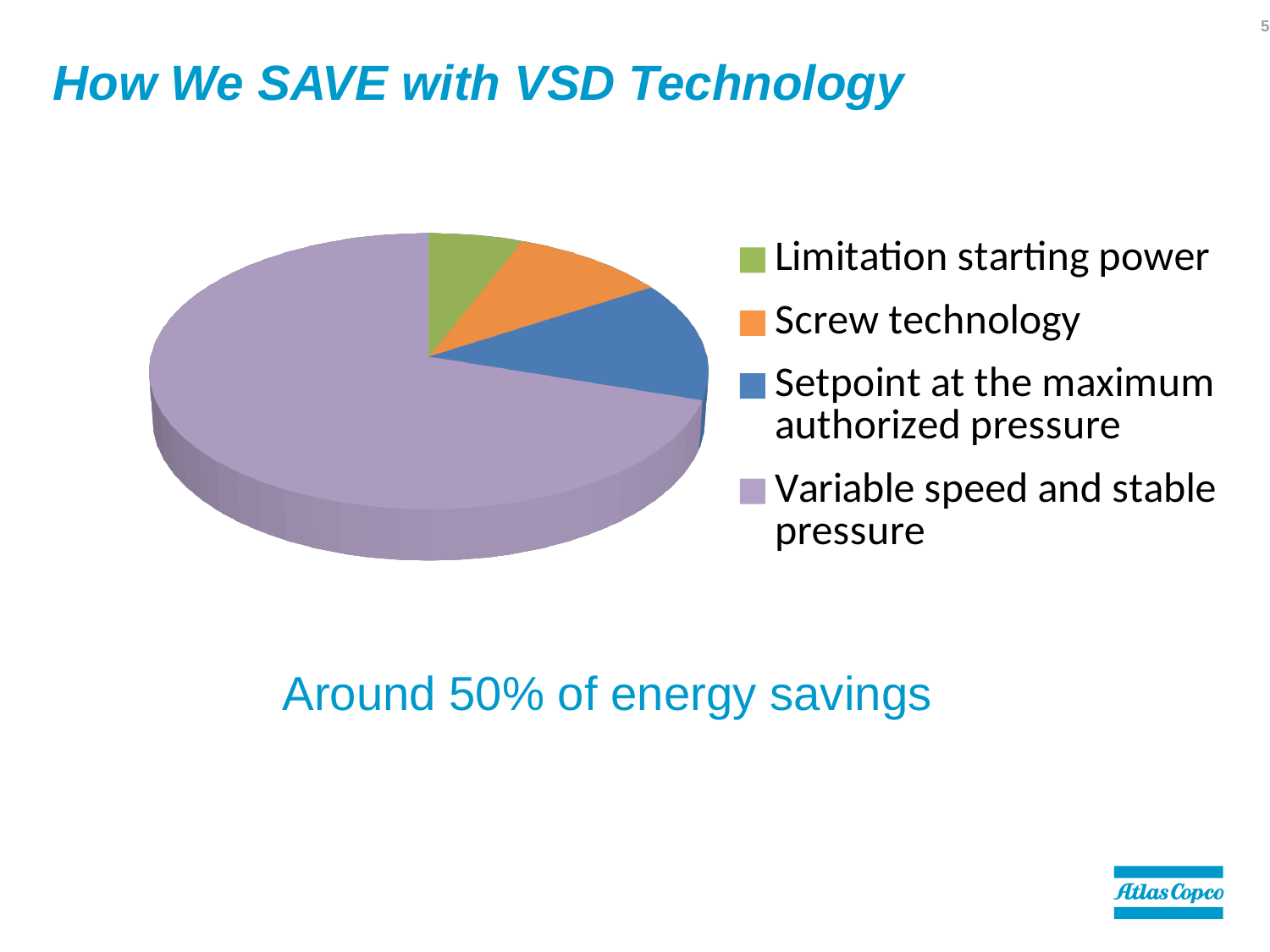
Which category has the largest slice of the pie chart? Variable speed and stable pressure Which slice is larger: Limitation starting power or Screw technology? Screw technology What is the title of the slide containing the pie chart? How We SAVE with VSD Technology Which slice is larger: Limitation starting power or Setpoint at the maximum authorized pressure? Setpoint at the maximum authorized pressure Which category has the smallest slice of the pie chart? Limitation starting power Does the Variable speed and stable pressure slice take up more or less than half of the pie? More What kind of chart is shown on the slide? Pie chart How many entries does the legend of the pie chart list? 4 How many slices does the pie chart have? 4 What colour is the slice for Screw technology in the pie chart? Orange